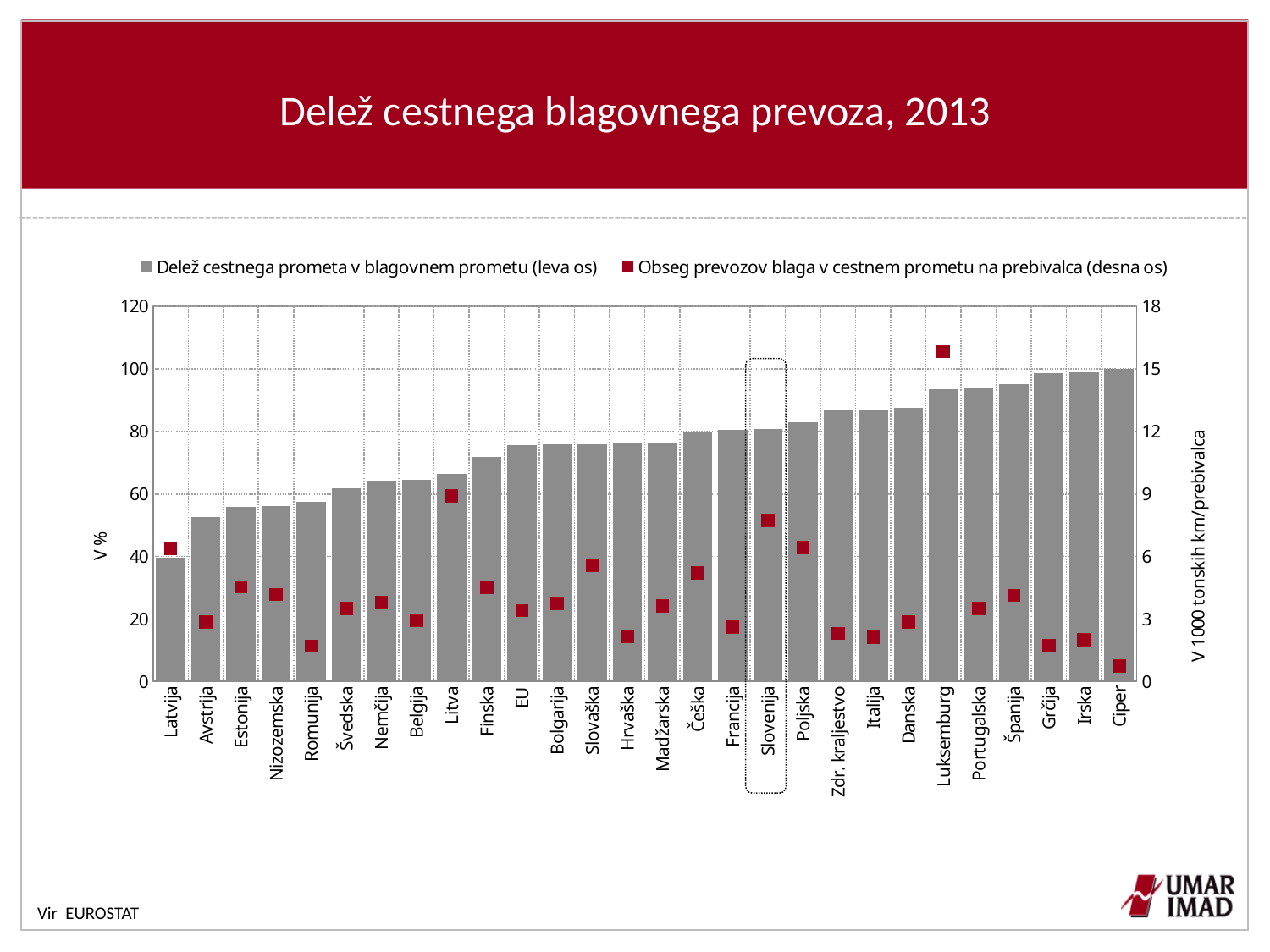
Which category has the lowest marker for 'Obseg prevozov blaga v cestnem prometu na prebivalca'? Ciper Which category has the highest marker for 'Obseg prevozov blaga v cestnem prometu na prebivalca'? Luksemburg What kind of chart is shown on the slide? bar chart with markers (combination chart) How many categories are shown on the x axis? 28 How many series does the legend list? 2 Is the bar value for Latvija greater or less than 60? less Do the bar values rise or fall from left to right along the x axis? rise Which category has the lowest bar for 'Delež cestnega prometa v blagovnem prometu'? Latvija Which has the larger marker value for 'Obseg prevozov blaga v cestnem prometu na prebivalca', Slovenija or Poljska? Slovenija Is the marker value for Romunija on the right axis greater or less than 3? less Which category has the highest bar for 'Delež cestnega prometa v blagovnem prometu'? Ciper Is the marker value for Luksemburg on the right axis greater or less than 15? greater